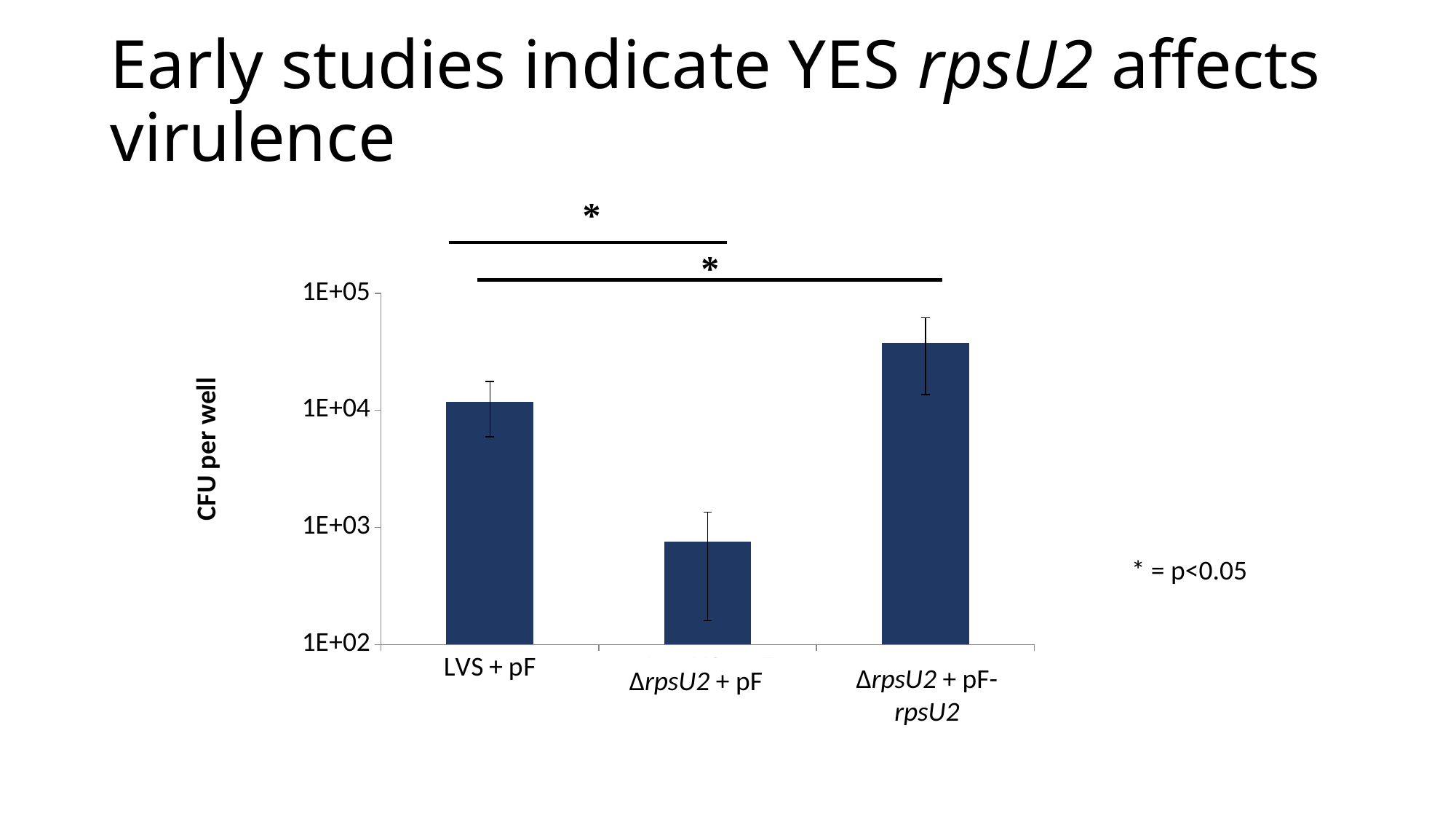
Which has the larger CFU per well, LVS + pF or ΔrpsU2 + pF? LVS + pF According to the note on the slide, what does the asterisk (*) indicate? p<0.05 Which category has the lowest CFU per well? ΔrpsU2 + pF Is the value for LVS + pF greater or less than 1E+05? less Is the value for ΔrpsU2 + pF greater or less than 1E+02? greater Is the value for ΔrpsU2 + pF-rpsU2 greater or less than 1E+04? greater Which category has the highest CFU per well? ΔrpsU2 + pF-rpsU2 Which has the larger CFU per well, ΔrpsU2 + pF-rpsU2 or ΔrpsU2 + pF? ΔrpsU2 + pF-rpsU2 How many categories are plotted on the x axis? 3 What kind of chart is shown on the slide? bar chart What is the label of the y axis? CFU per well